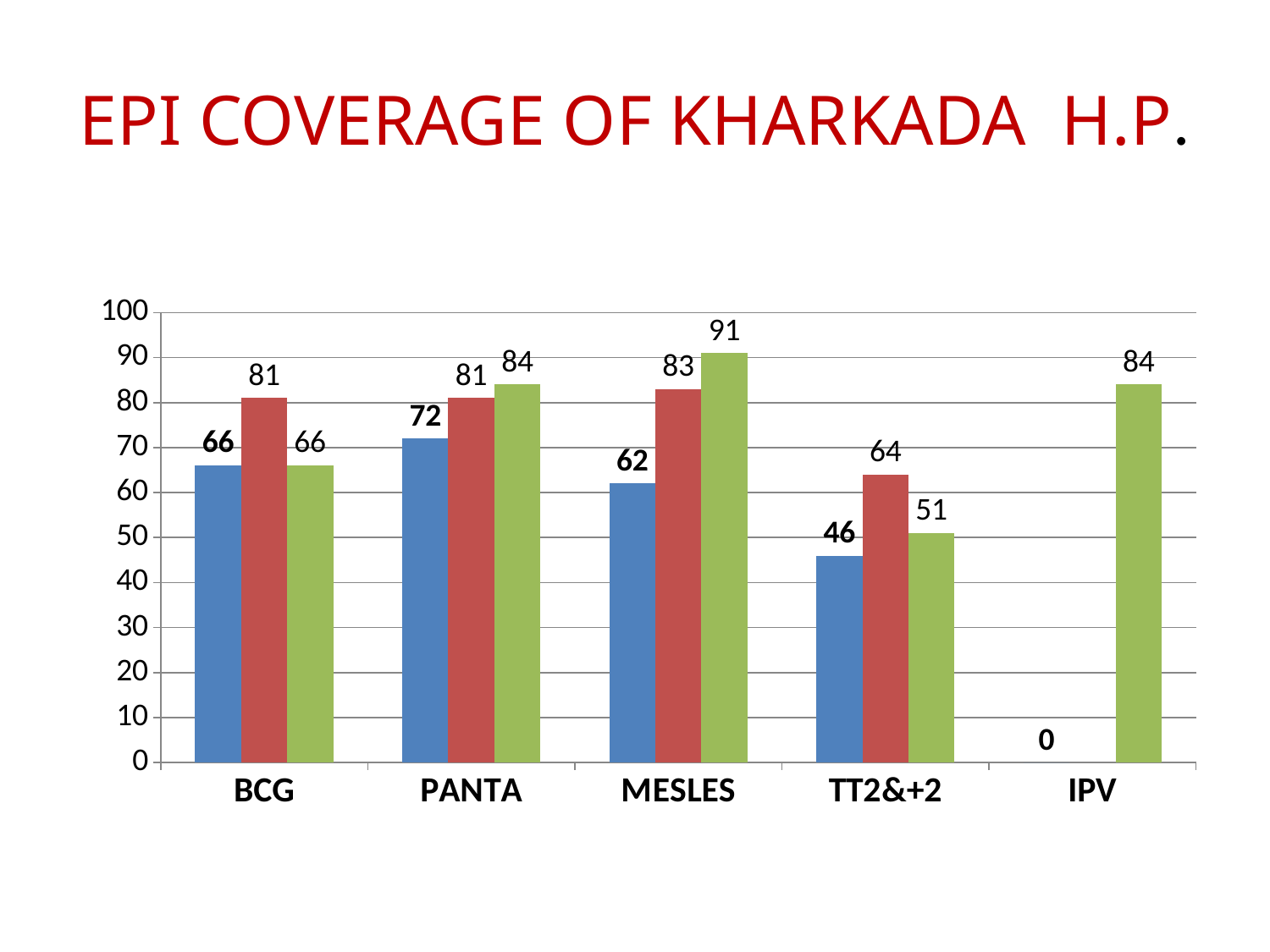
What is the value of the green bar for MESLES? 91 What is the difference between the red bar for MESLES and the red bar for TT2&+2? 19 What is the value of the green bar for IPV? 84 What is the difference between the green bar and the blue bar for TT2&+2? 5 What is the value of the red bar for TT2&+2? 64 What type of chart is shown on the slide? bar chart What is the title of the slide? EPI COVERAGE OF KHARKADA H.P. Which is larger for BCG, the red bar or the green bar? the red bar Which category has the highest green bar? MESLES What is the value of the blue bar for PANTA? 72 How many categories are shown on the x axis? 5 Which category has the lowest blue bar? IPV